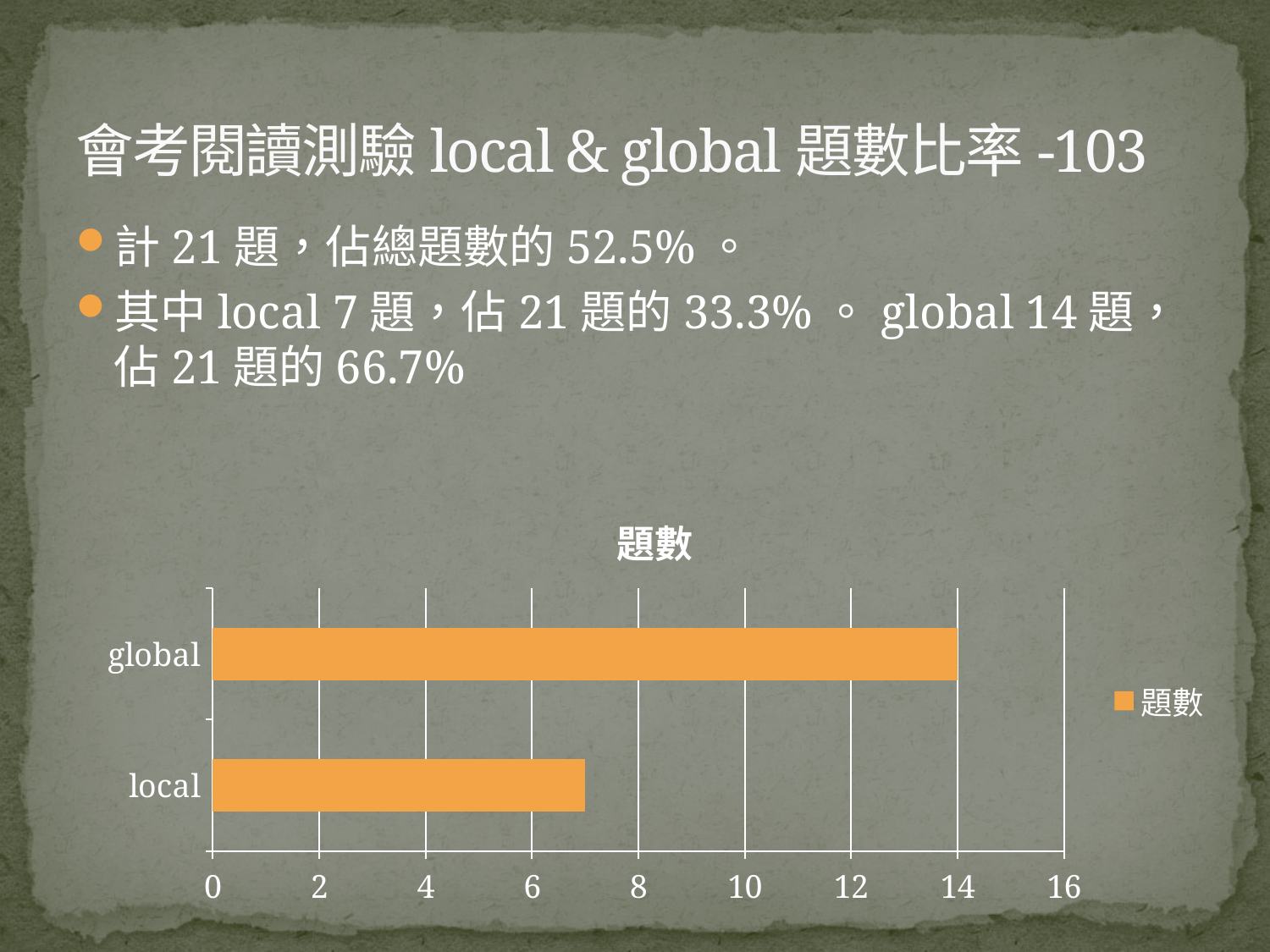
How many categories does the chart show? 2 Which category has the highest value? global How many series does the legend list? 1 Is the value for local greater or less than 8? less What kind of chart is shown on the slide? bar chart What is the title of the chart? 題數 Which is larger, the value for global or the value for local? global What is the difference between the value for global and the value for local? 7 What is the value for local in the chart? 7 Which category has the lowest value? local Is the value for global greater or less than 12? greater What is the value for global in the chart? 14